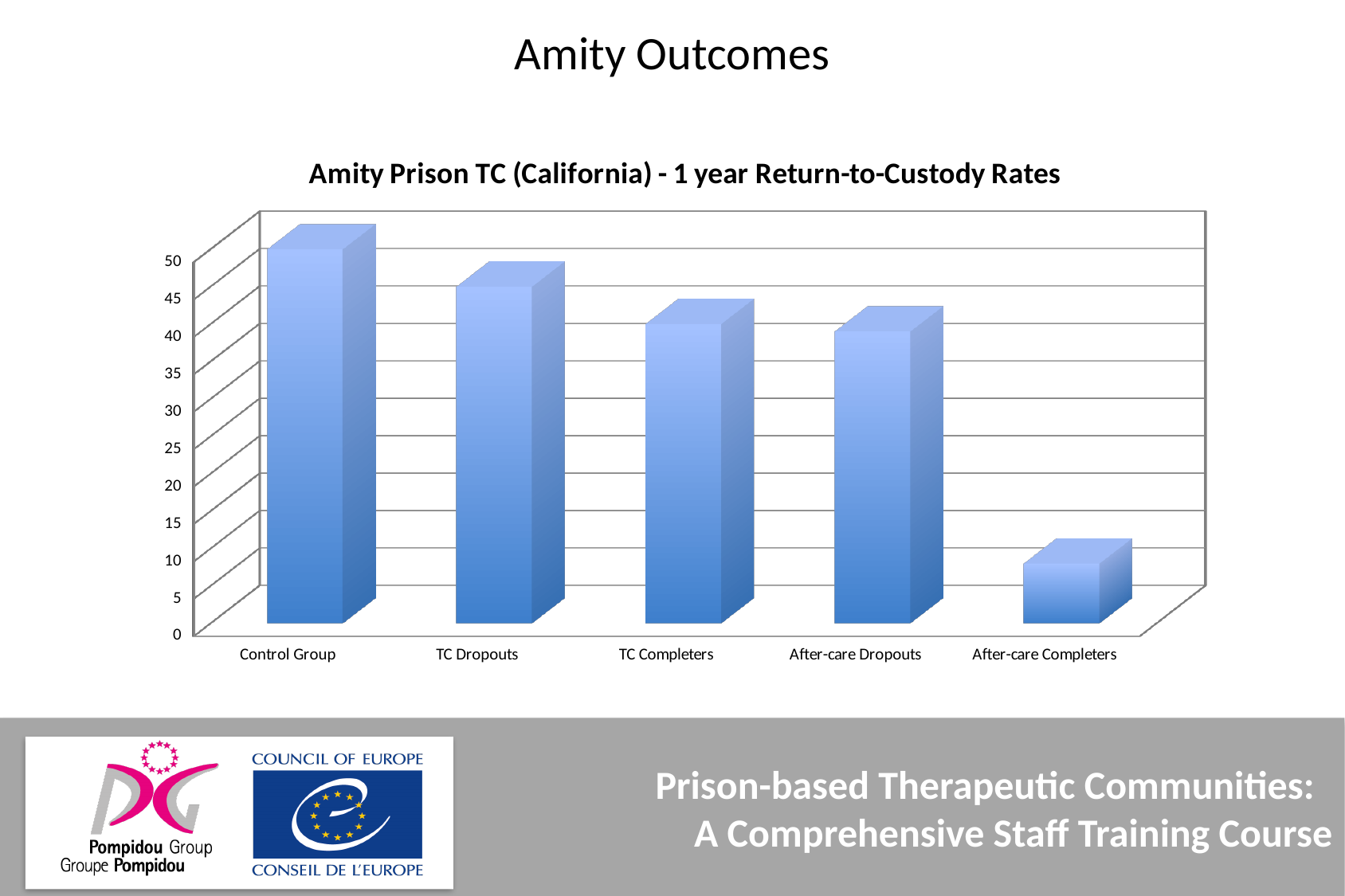
Which is larger, the value for TC Dropouts or the value for TC Completers? TC Dropouts Which category has the highest return-to-custody rate? Control Group What kind of chart is shown on the slide? Bar chart What is the title of the chart? Amity Prison TC (California) - 1 year Return-to-Custody Rates Is the value for After-care Dropouts greater or less than 45? less Is the value for After-care Completers greater or less than 15? less How many categories are shown on the x axis of the chart? 5 Do the values generally rise or fall moving from left to right along the x axis? Fall Which category has the lowest return-to-custody rate? After-care Completers Is the value for Control Group greater or less than 40? greater Which is larger, the value for Control Group or the value for After-care Completers? Control Group